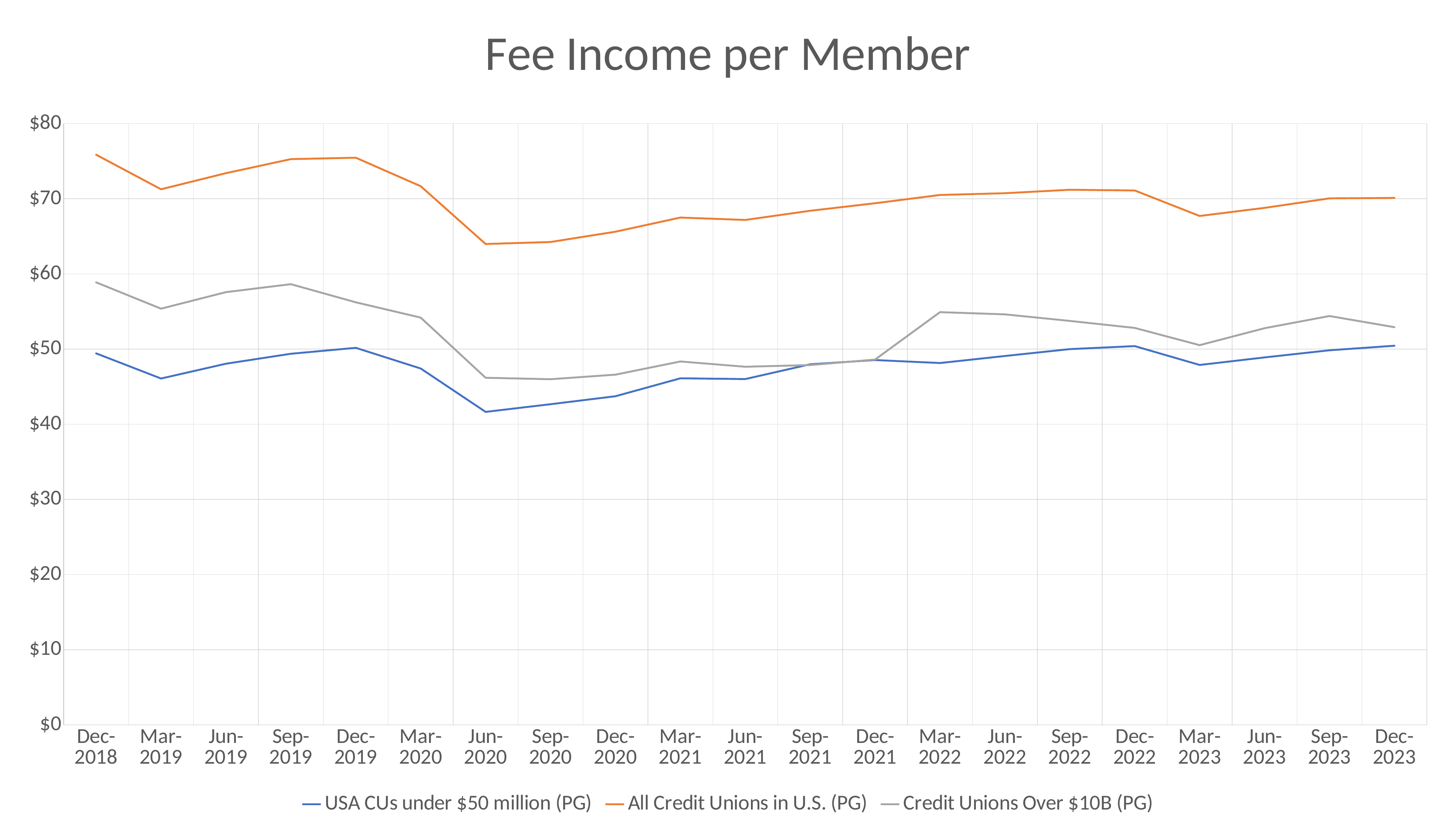
Is the value for All Credit Unions in U.S. (PG) at Jun-2020 greater or less than $70? less What is the title of the chart? Fee Income per Member At Mar-2022, which series has the larger value: Credit Unions Over $10B (PG) or USA CUs under $50 million (PG)? Credit Unions Over $10B (PG) How many series does the legend list? 3 How many time points are plotted along the x axis? 21 Is the value for USA CUs under $50 million (PG) at Jun-2020 greater or less than $50? less At Dec-2018, which series has the larger value: All Credit Unions in U.S. (PG) or USA CUs under $50 million (PG)? All Credit Unions in U.S. (PG) Does the All Credit Unions in U.S. (PG) series rise or fall from Dec-2019 to Jun-2020? fall Is the value for Credit Unions Over $10B (PG) at Dec-2018 greater or less than $60? less At which time point is the USA CUs under $50 million (PG) series at its lowest? Jun-2020 What kind of chart is shown on the slide? line chart